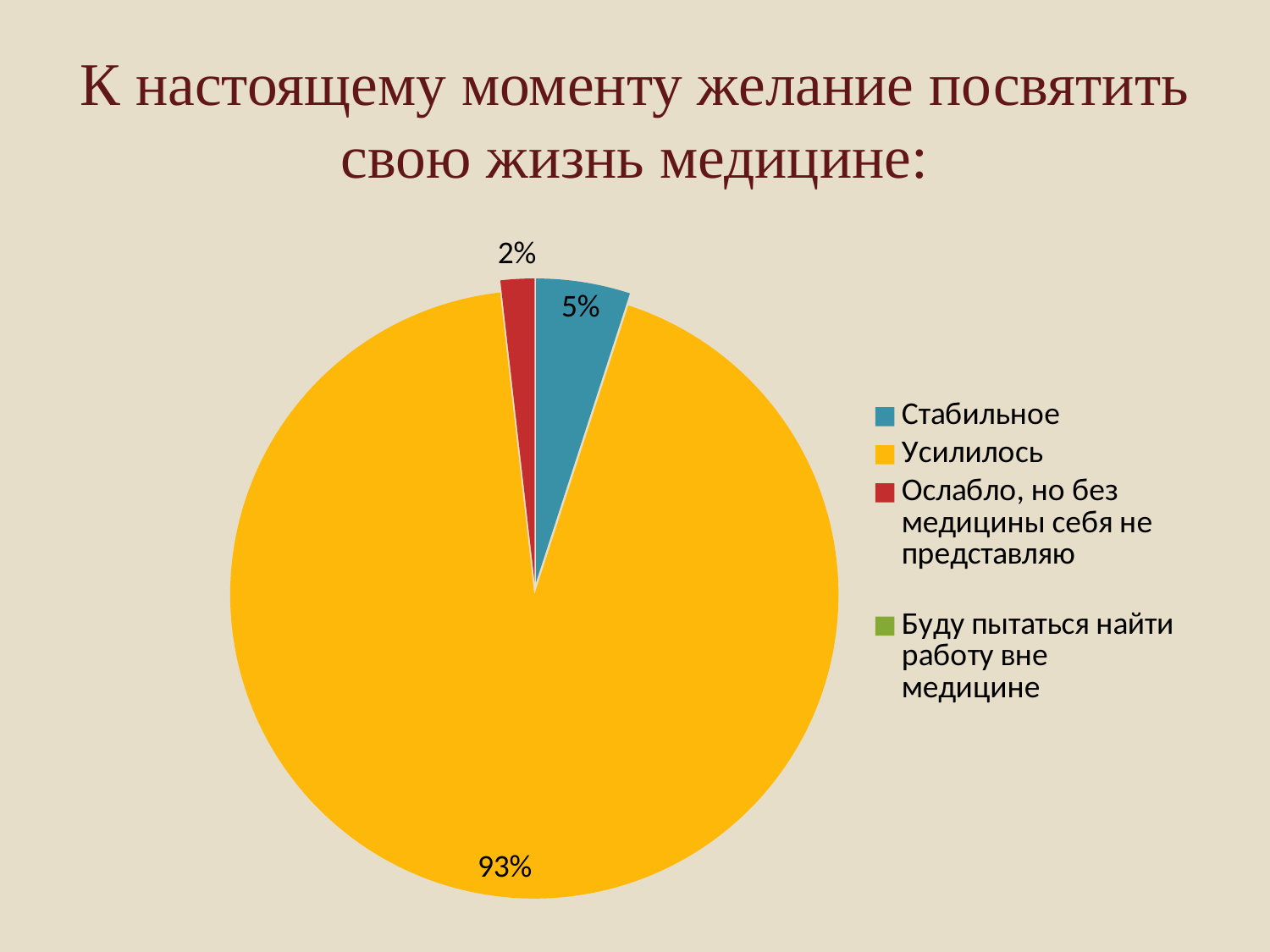
What colour is the slice for "Усилилось"? yellow How many entries does the legend list? 4 What is the difference in percentage points between "Стабильное" and "Ослабло, но без медицины себя не представляю"? 3 Which is larger, the slice for "Стабильное" or the slice for "Ослабло, но без медицины себя не представляю"? Стабильное What share of the pie does "Усилилось" take? 93% Which legend entry is shown in green? Буду пытаться найти работу вне медицине What share of the pie does "Стабильное" take? 5% Which category has the largest slice of the pie? Усилилось What kind of chart is shown on the slide? pie chart Which of the slices with a printed value is the smallest? Ослабло, но без медицины себя не представляю What share of the pie does "Ослабло, но без медицины себя не представляю" take? 2% What is the difference in percentage points between "Усилилось" and "Стабильное"? 88